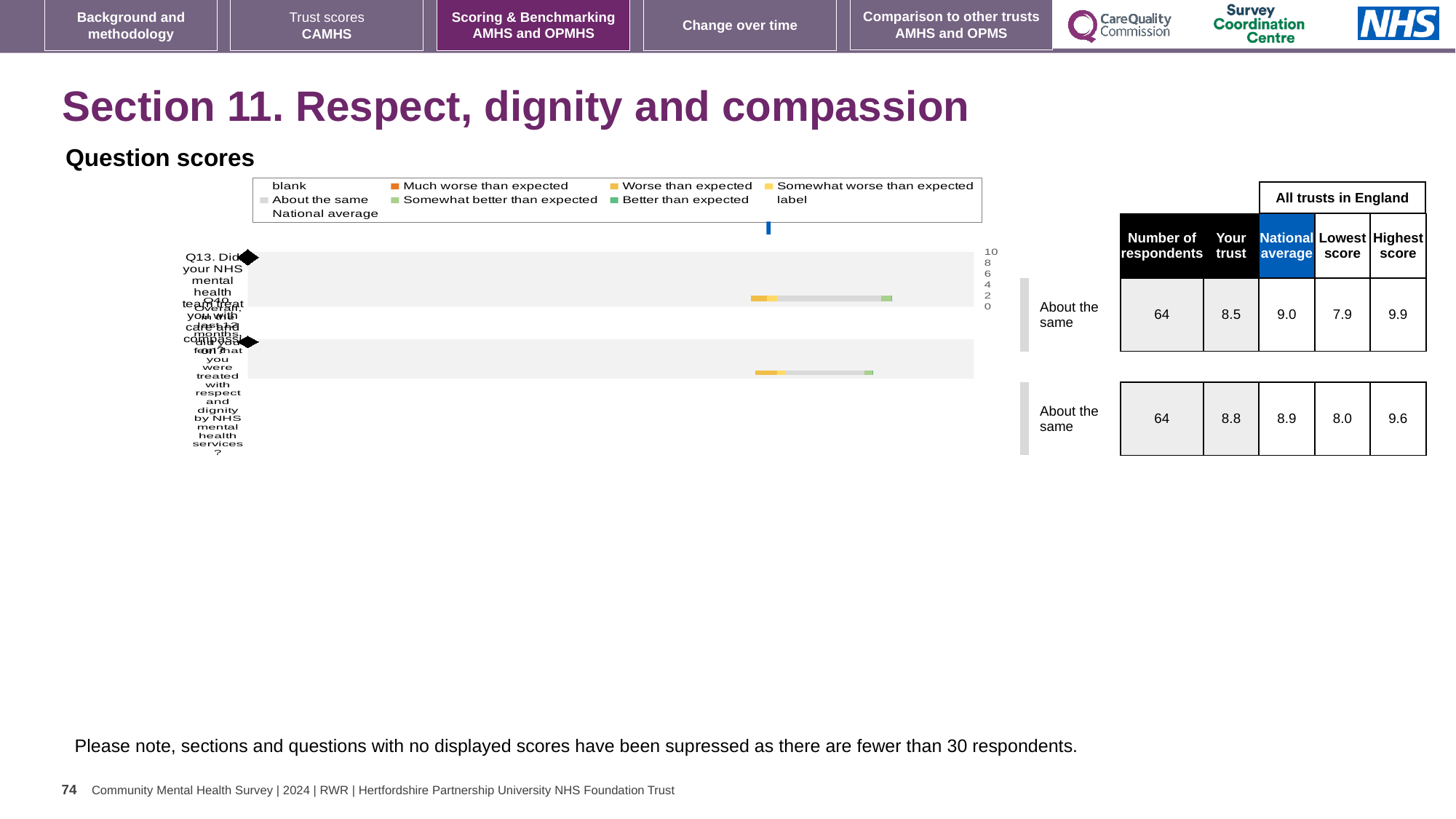
In the table next to the chart, what is the 'Highest score' in the bottom row? 9.6 What benchmark label is shown beside each row of the table (e.g. 'Better than expected', 'About the same')? About the same What kind of chart is shown under 'Question scores'? bar chart How many questions (categories) are plotted in the Question scores chart? 2 In the top row of the table, what is the difference between the 'National average' (9.0) and the 'Your trust' score (8.5)? 0.5 What is the heading above the 'National average', 'Lowest score' and 'Highest score' columns of the table? All trusts in England In the table next to the chart, what is the 'Your trust' score in the top row? 8.5 In the table next to the chart, how many respondents are shown in the bottom row? 64 In the top row of the table, which is larger: the 'Your trust' score or the 'National average'? National average In the table next to the chart, what is the 'National average' in the top row? 9.0 In the bottom row of the table, what is the difference between the 'Highest score' (9.6) and the 'Lowest score' (8.0)? 1.6 In the table next to the chart, what is the 'Lowest score' in the top row? 7.9